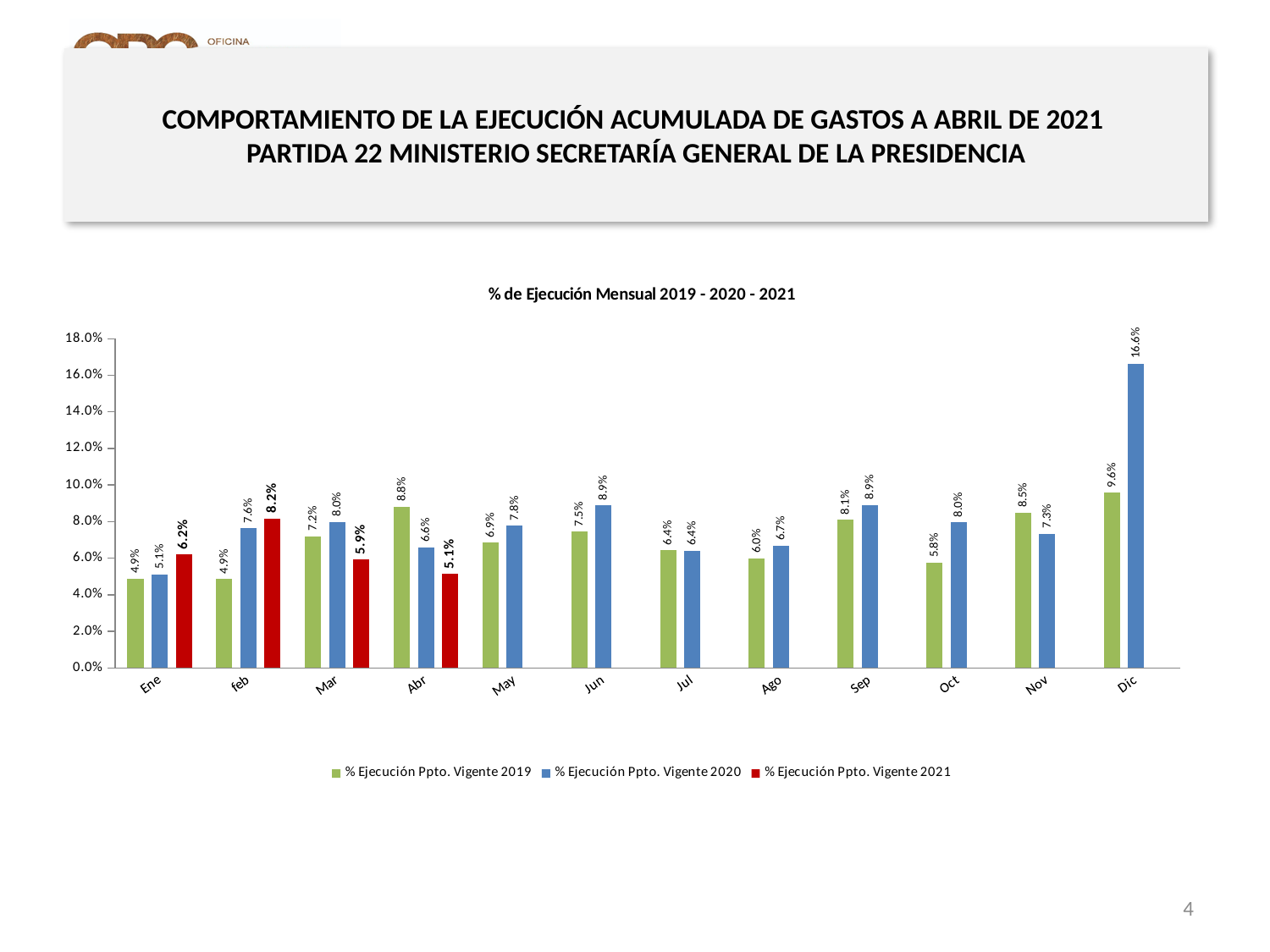
What is the difference between the 2020 and 2019 values for Dic? 7.0% Which month has the highest value for % Ejecución Ppto. Vigente 2020? Dic Which month has the lowest value for % Ejecución Ppto. Vigente 2021? Abr How many series does the legend list? 3 For Mar, which is larger: the 2019 value or the 2020 value? 2020 What is the value of % Ejecución Ppto. Vigente 2021 for Ene? 6.2% How many months are shown on the x axis? 12 What is the value of % Ejecución Ppto. Vigente 2020 for Dic? 16.6% Is the value for % Ejecución Ppto. Vigente 2020 in Dic greater or less than 14.0%? greater What is the value of % Ejecución Ppto. Vigente 2019 for Abr? 8.8% What kind of chart is shown? Bar chart What colour represents % Ejecución Ppto. Vigente 2021? Red